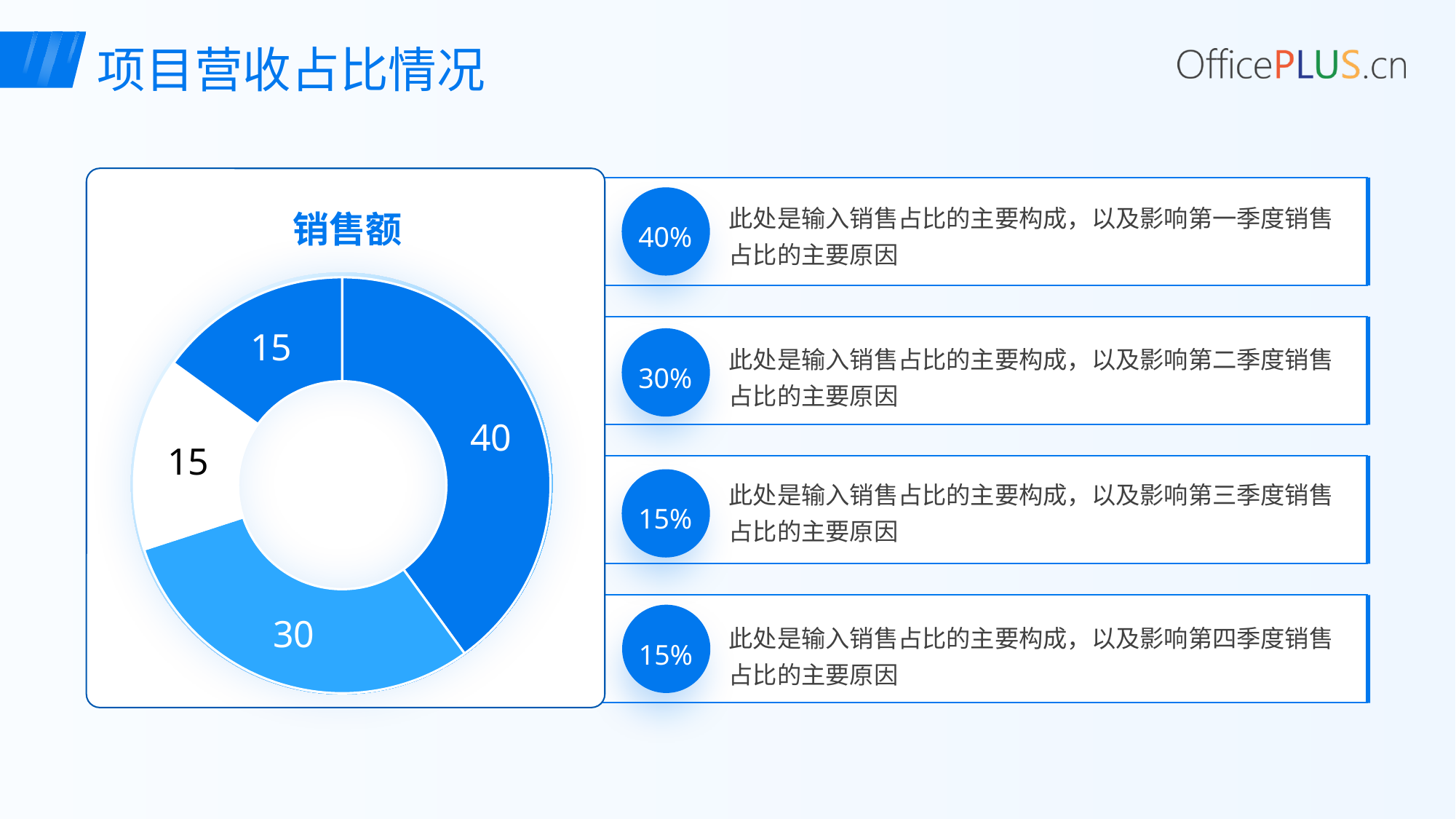
What is the difference between the largest slice (40) and the slice labelled 30? 10 What is the value of the smallest slices in the doughnut chart? 15 How many slices in the doughnut chart have the value 15? 2 Which is larger, the slice labelled 30 or the slice labelled 40? 40 What is the title of the chart? 销售额 What is the value of the light blue slice at the bottom of the doughnut chart? 30 How many slices does the doughnut chart have? 4 What is the total of all slice values in the doughnut chart? 100 What kind of chart is shown on the slide? Doughnut chart What is the value of the dark blue slice on the right side of the doughnut chart? 40 What is the value of the largest slice in the doughnut chart? 40 What is the value of the white slice on the left side of the doughnut chart? 15